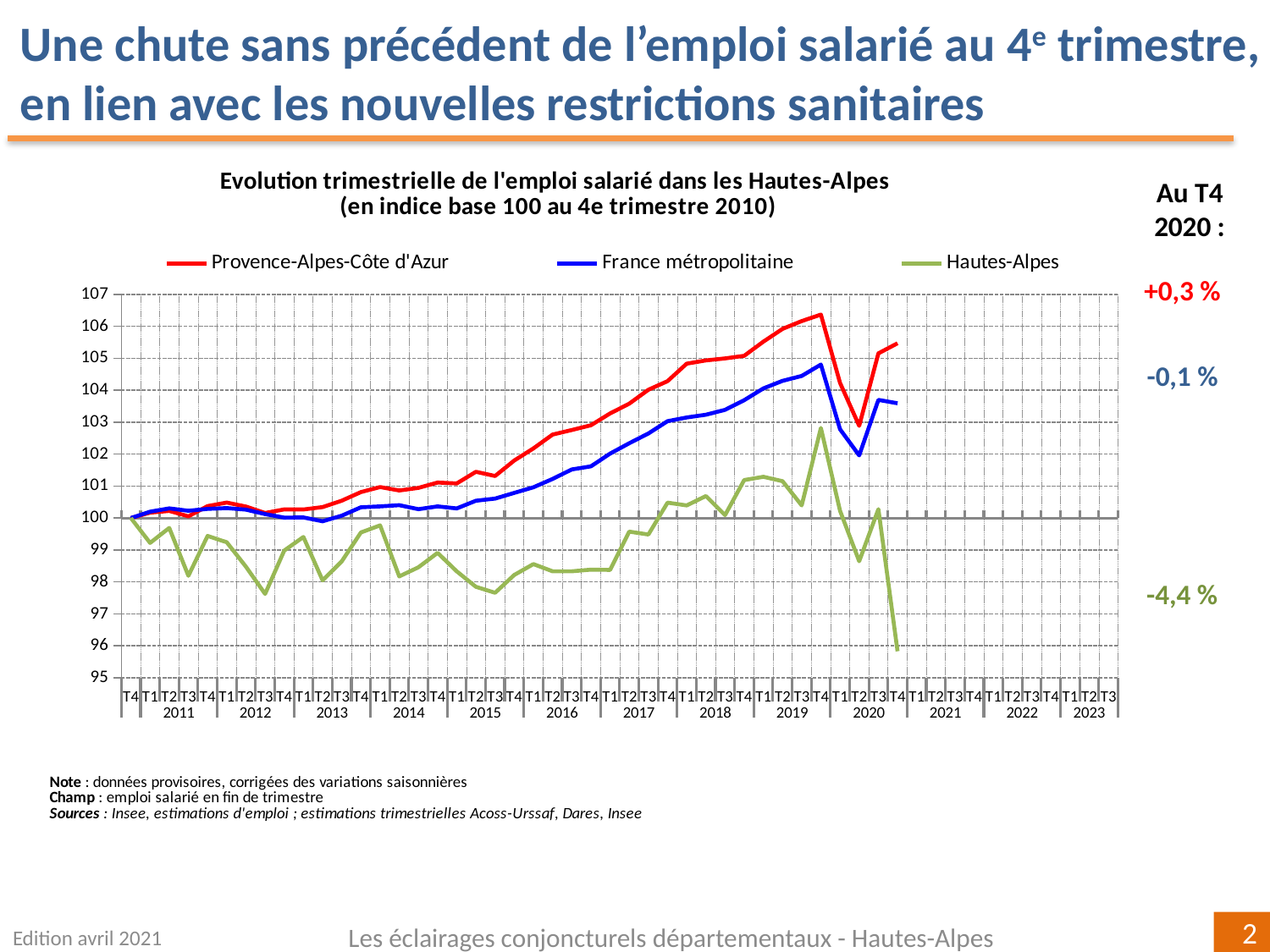
Does the Hautes-Alpes line rise or fall between T3 2020 and T4 2020? fall At T4 2020, which is larger: the value for France métropolitaine or the value for Hautes-Alpes? France métropolitaine Is the value for Hautes-Alpes at T4 2020 greater or less than 97? less Which series has the lowest value at T4 2020? Hautes-Alpes Is the value for Provence-Alpes-Côte d'Azur at T4 2019 greater or less than 105? greater Is the value for Hautes-Alpes at T4 2019 greater or less than 102? greater Does the Provence-Alpes-Côte d'Azur line generally rise or fall between 2013 and 2019? rise How many series does the legend list? 3 Which series has the highest value at T4 2020? Provence-Alpes-Côte d'Azur What kind of chart is shown on the slide? line chart What change at T4 2020 is annotated next to the chart for Hautes-Alpes? -4,4 %